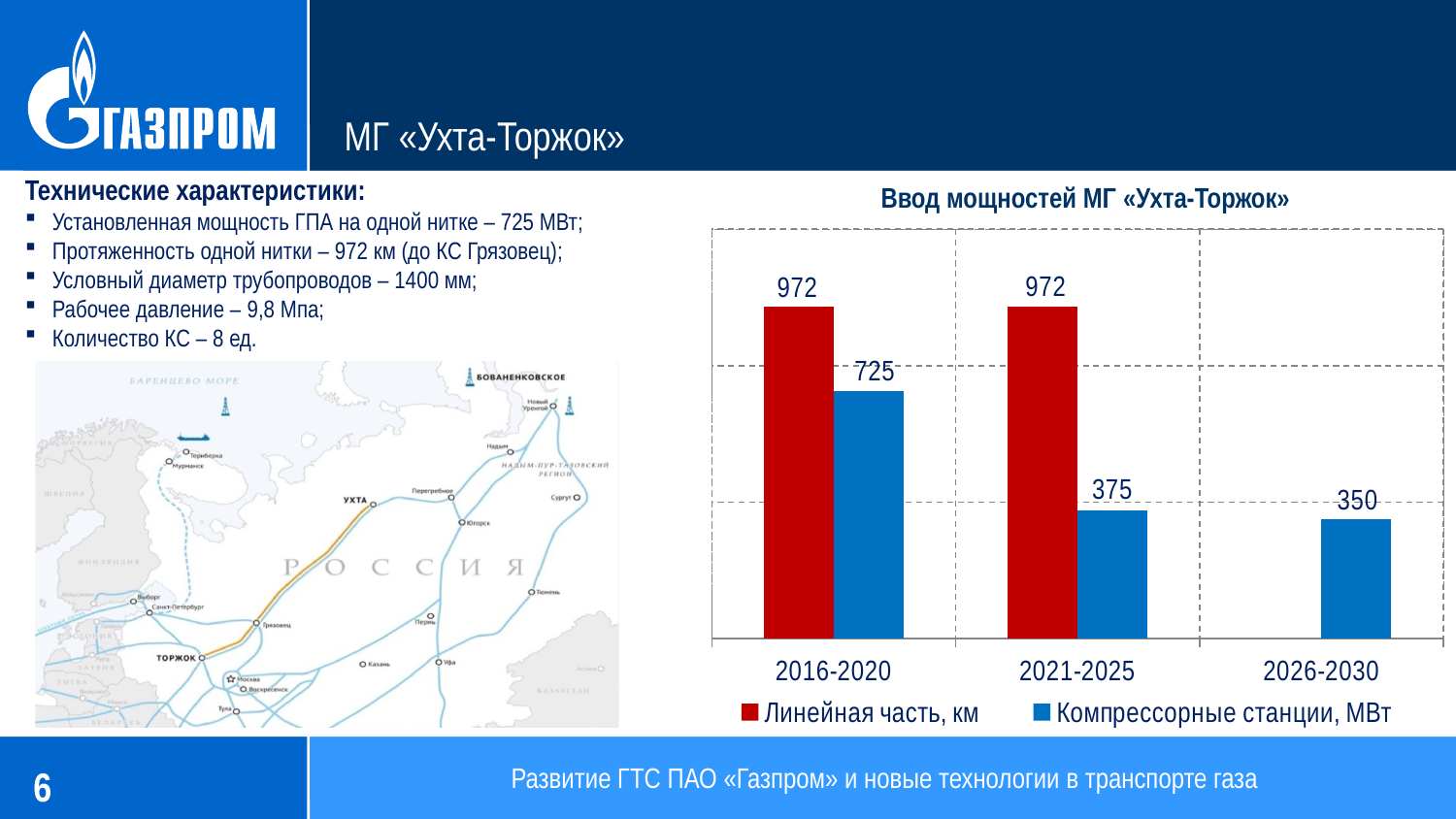
How many series does the chart legend list? 2 What is the value of Компрессорные станции, МВт for 2021-2025? 375 How many periods are shown on the x axis of the chart? 3 What is the difference between the Компрессорные станции, МВт values for 2016-2020 and 2021-2025? 350 What is the value of Компрессорные станции, МВт for 2026-2030? 350 What is the value of Линейная часть, км for 2021-2025? 972 What is the value of Компрессорные станции, МВт for 2016-2020? 725 Which period has the highest value for Компрессорные станции, МВт? 2016-2020 Which is larger: Линейная часть, км for 2016-2020 or Компрессорные станции, МВт for 2016-2020? Линейная часть, км for 2016-2020 What is the title of the chart? Ввод мощностей МГ «Ухта-Торжок» Which period has the lowest value for Компрессорные станции, МВт? 2026-2030 What kind of chart is shown on the slide? Bar chart